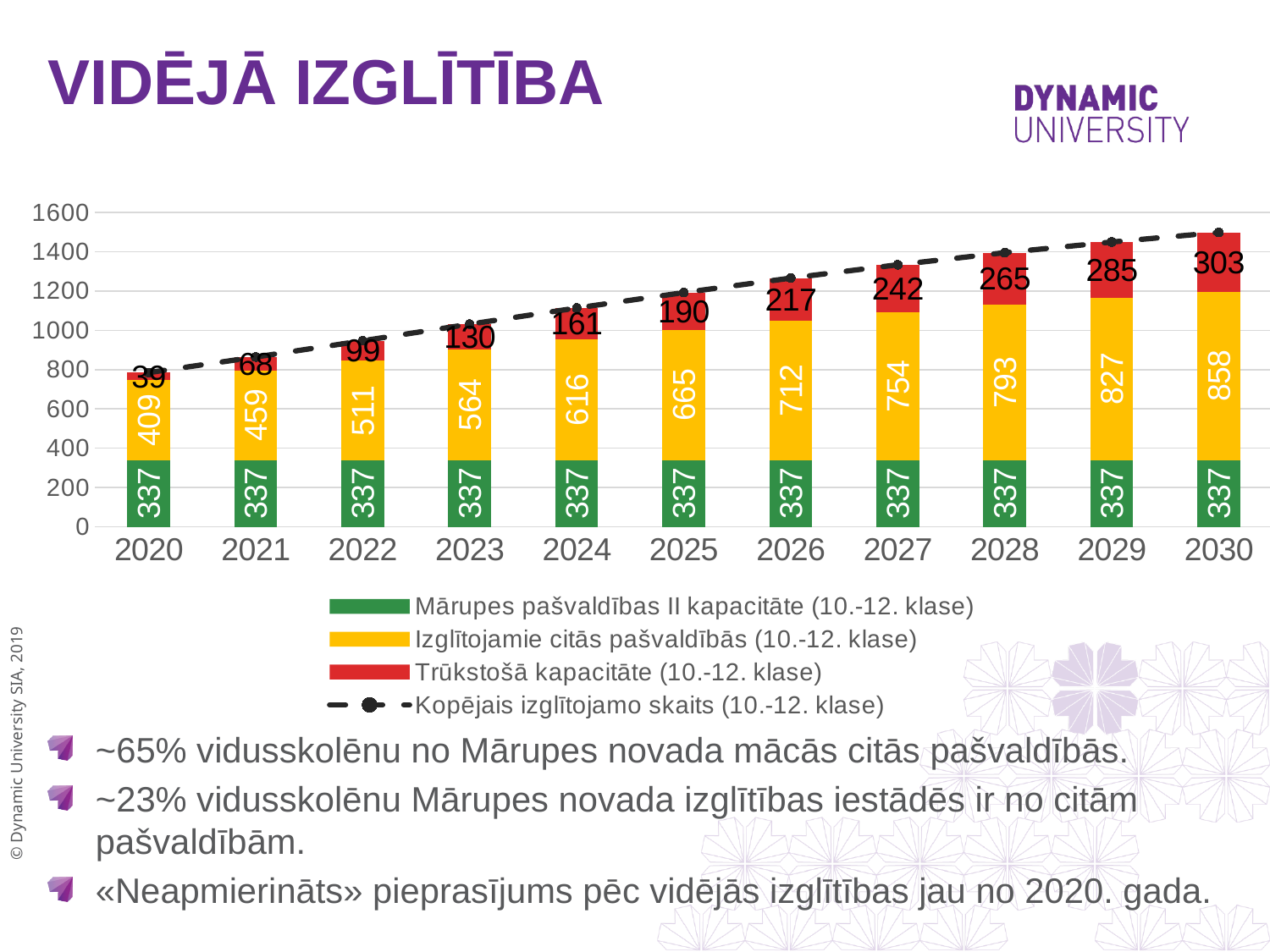
In which year is 'Izglītojamie citās pašvaldībās (10.-12. klase)' the highest? 2030 What is the value of 'Mārupes pašvaldības II kapacitāte (10.-12. klase)' for 2022? 337 What is the total of the stacked bar for 2030? 1498 In which year is 'Trūkstošā kapacitāte (10.-12. klase)' the lowest? 2020 What is the value of 'Trūkstošā kapacitāte (10.-12. klase)' for 2030? 303 What is the value of 'Izglītojamie citās pašvaldībās (10.-12. klase)' for 2025? 665 Which is larger: 'Trūkstošā kapacitāte (10.-12. klase)' in 2024 or in 2027? 2027 How many series does the legend list? 4 Does 'Trūkstošā kapacitāte (10.-12. klase)' rise or fall from 2020 to 2030? rise How many years are shown on the x axis? 11 What is the difference between the 'Izglītojamie citās pašvaldībās (10.-12. klase)' values for 2030 and 2020? 449 What is the total of the stacked bar for 2020? 785